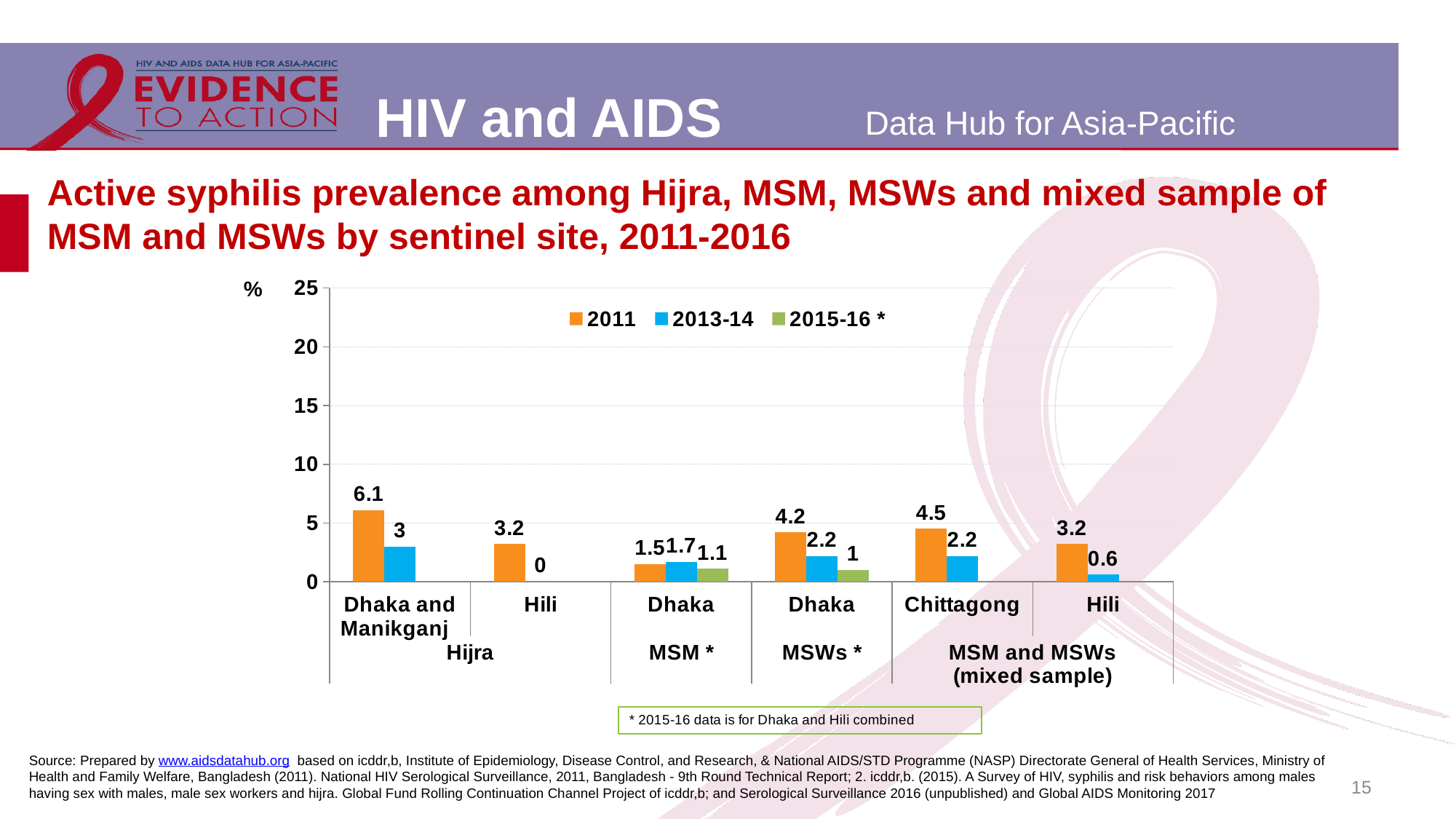
Which is larger, the 2011 value for Chittagong (mixed sample) or the 2011 value for MSWs in Dhaka? Chittagong (mixed sample) Which site has the lowest 2013-14 value? Hili (Hijra) What is the 2013-14 value for Hijra in Hili? 0 What kind of chart is shown on the slide? Bar chart How many series does the legend list? 3 What is the difference between the 2011 and 2013-14 values for MSWs in Dhaka? 2 How many sentinel sites are shown on the x axis? 6 Do the values for MSWs in Dhaka rise or fall from 2011 to 2015-16? Fall Which site has the highest 2011 value? Dhaka and Manikganj (Hijra) What is the 2013-14 value for the MSM and MSWs mixed sample in Hili? 0.6 What is the 2015-16 value for MSM in Dhaka? 1.1 What is the 2011 active syphilis prevalence for Hijra in Dhaka and Manikganj? 6.1